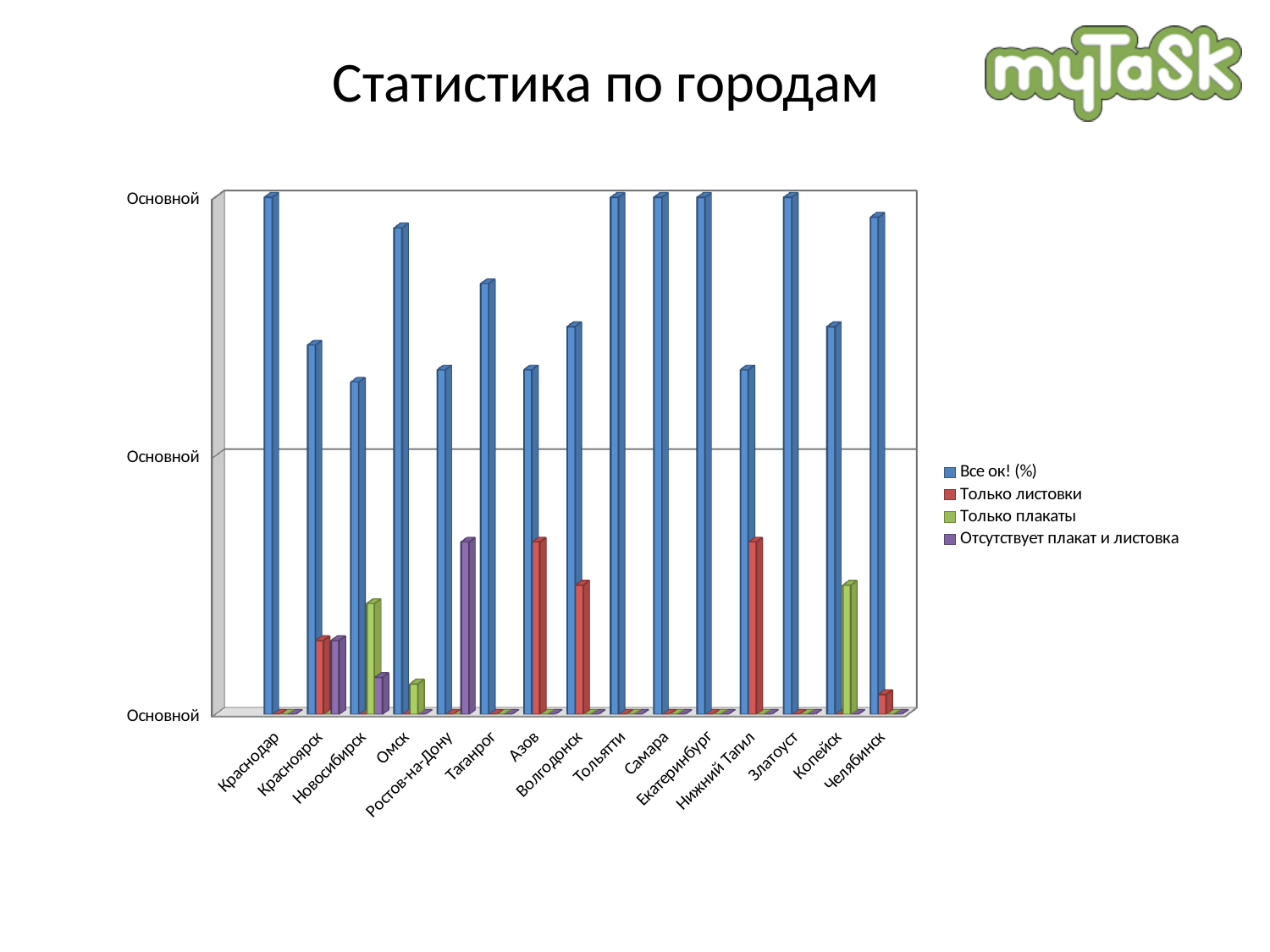
What kind of chart is shown on the slide? bar chart What is the title of the slide? Статистика по городам How many cities are shown on the x axis of the chart? 15 For the 'Все ок! (%)' series, which is larger: Омск or Красноярск? Омск For the 'Все ок! (%)' series, which is larger: Таганрог or Волгодонск? Таганрог Which city has the highest value for 'Отсутствует плакат и листовка'? Ростов-на-Дону For the 'Только плакаты' series, which is larger: Новосибирск or Красноярск? Новосибирск Which city has the highest value for 'Только плакаты'? Копейск How many series does the chart legend list? 4 Which series is shown in blue in the chart? Все ок! (%)